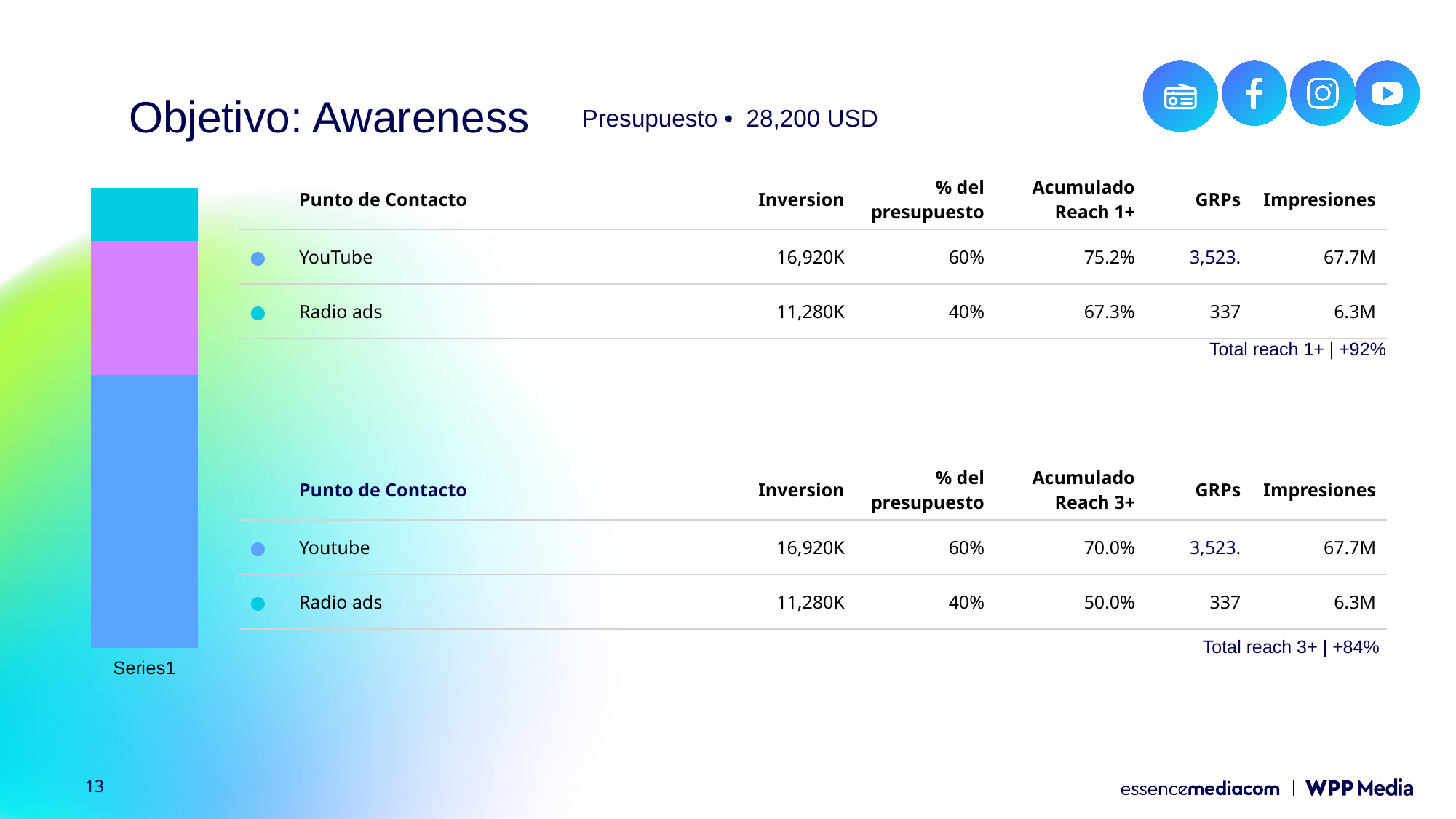
In the stacked bar on the left, is the purple segment larger or smaller than the cyan segment? larger What kind of chart is shown on the left of the slide? bar chart Which coloured segment of the stacked bar on the left is the smallest? cyan What is the label of the single category in the bar chart on the left? Series1 How many coloured segments make up the stacked bar in the chart on the left? 3 Which coloured segment of the stacked bar on the left is the largest? blue How many categories does the bar chart on the left show along its x axis? 1